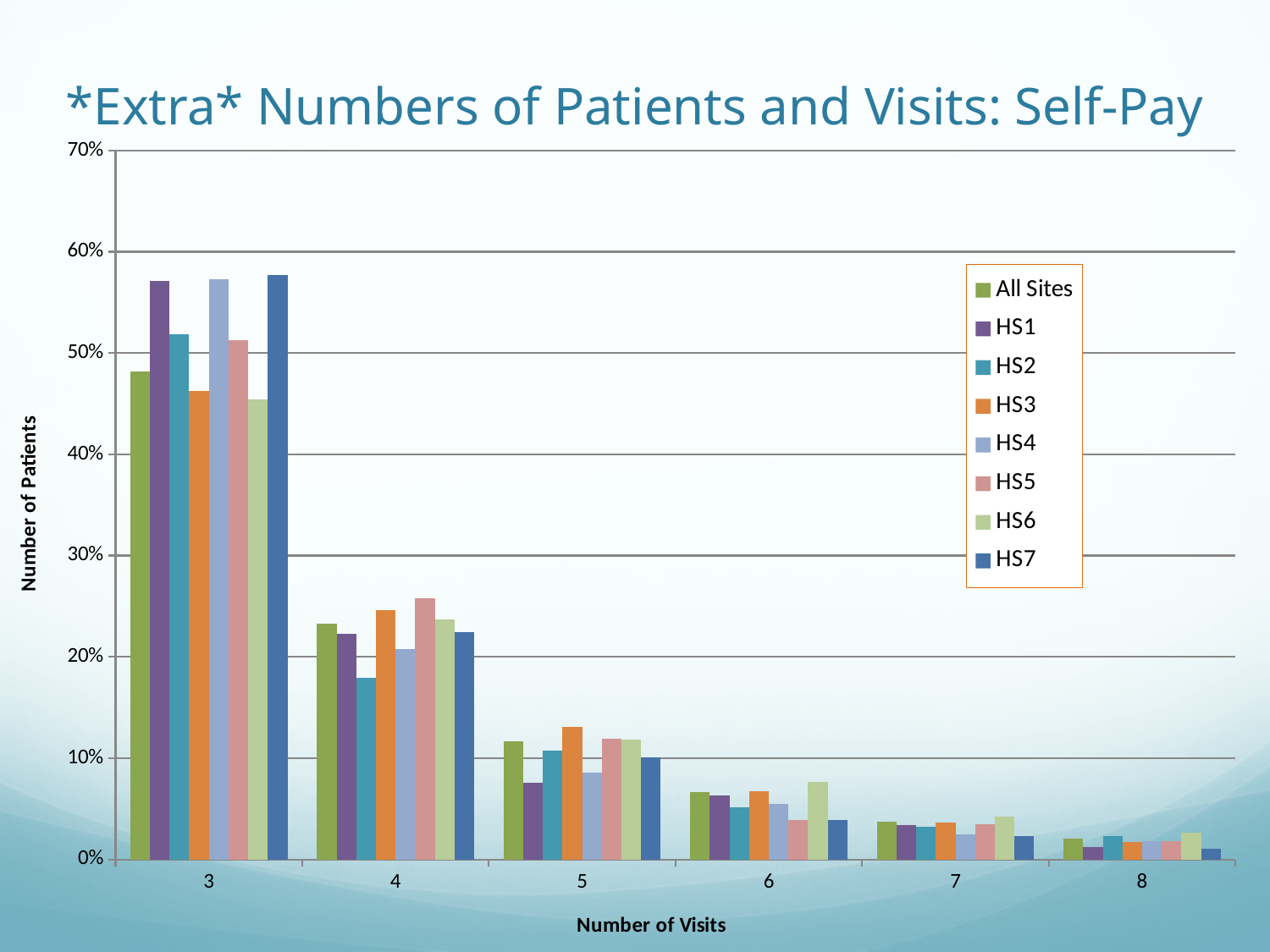
Do the All Sites values rise or fall as the number of visits increases from 3 to 8? fall Which series has the lowest value for 4 visits? HS2 Is the HS3 value for 5 visits greater or less than 10%? greater Is the HS7 value for 3 visits greater or less than 50%? greater Is the HS2 value for 4 visits greater or less than 20%? less How many number-of-visits categories are shown on the x axis? 6 What is the title of the x axis? Number of Visits For 5 visits, which is larger: HS3 or HS1? HS3 What kind of chart is shown on the slide? bar chart For 4 visits, which is larger: HS5 or HS2? HS5 How many series does the legend list? 8